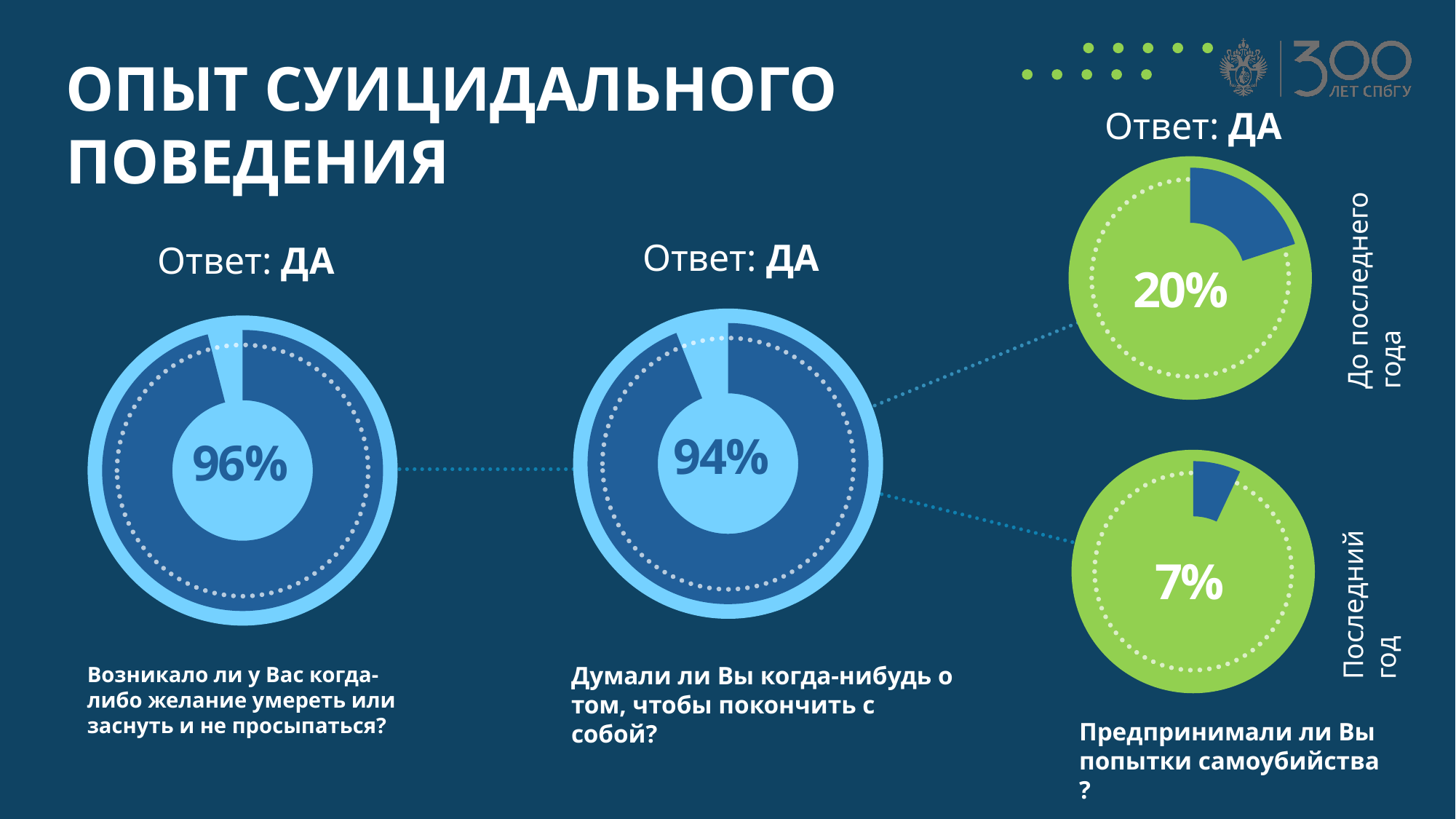
Which of the four charts on the slide shows the highest percentage? The left chart (96%) In the right-hand charts about suicide attempts ("Предпринимали ли Вы попытки самоубийства?"), what is the value for "Последний год"? 7% What colour are the two charts on the right side of the slide ("До последнего года" and "Последний год")? Green What percentage answered "ДА" to the question "Думали ли Вы когда-нибудь о том, чтобы покончить с собой?" (middle chart)? 94% What kind of chart is used to show the percentages on this slide? Doughnut chart How many circular charts are shown on the slide? 4 In the right-hand charts, what is the difference between the "До последнего года" value and the "Последний год" value? 13% In the right-hand charts about suicide attempts ("Предпринимали ли Вы попытки самоубийства?"), what is the value for "До последнего года"? 20% In the right-hand charts, which is larger: the value for "До последнего года" or for "Последний год"? До последнего года What is the difference between the left chart's value (96%) and the middle chart's value (94%)? 2% Which of the four charts on the slide shows the lowest percentage? The bottom-right chart, "Последний год" (7%) What percentage answered "ДА" to the question "Возникало ли у Вас когда-либо желание умереть или заснуть и не просыпаться?" (left chart)? 96%